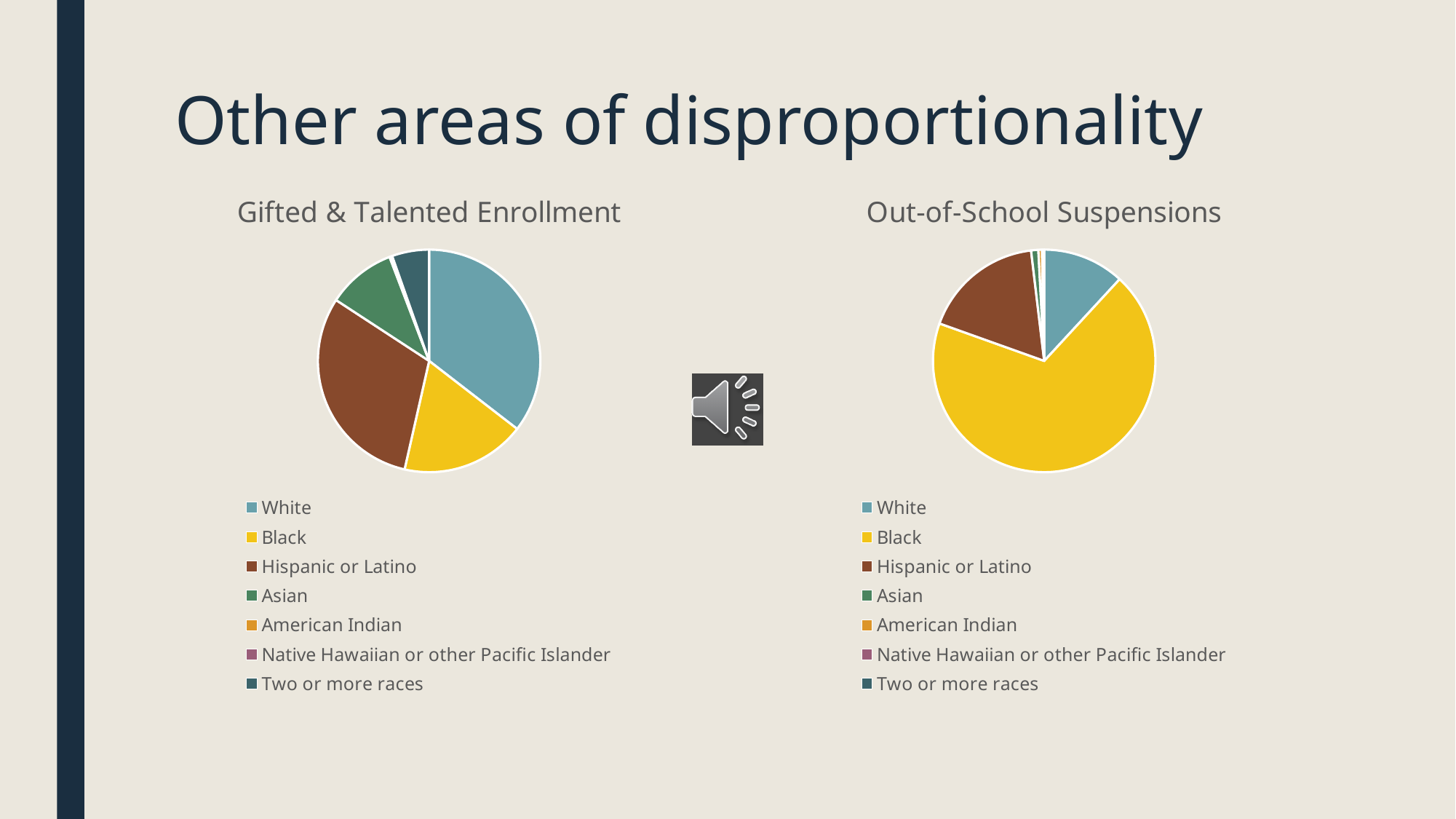
In the Gifted & Talented Enrollment chart, which slice is larger, White or Black? White What kind of chart is the Out-of-School Suspensions chart? Pie chart In the Out-of-School Suspensions chart, which slice is larger, Hispanic or Latino or Asian? Hispanic or Latino How many groups are listed in the legend of the Out-of-School Suspensions chart? 7 In the Out-of-School Suspensions chart, which group has the largest slice? Black In the Gifted & Talented Enrollment chart, which slice is larger, Hispanic or Latino or Asian? Hispanic or Latino In the Out-of-School Suspensions chart, what colour represents the Black group? Yellow What is the title of the chart on the left side of the slide? Gifted & Talented Enrollment What kind of chart is the Gifted & Talented Enrollment chart? Pie chart How many groups are listed in the legend of the Gifted & Talented Enrollment chart? 7 In the Gifted & Talented Enrollment chart, which group has the largest slice? White